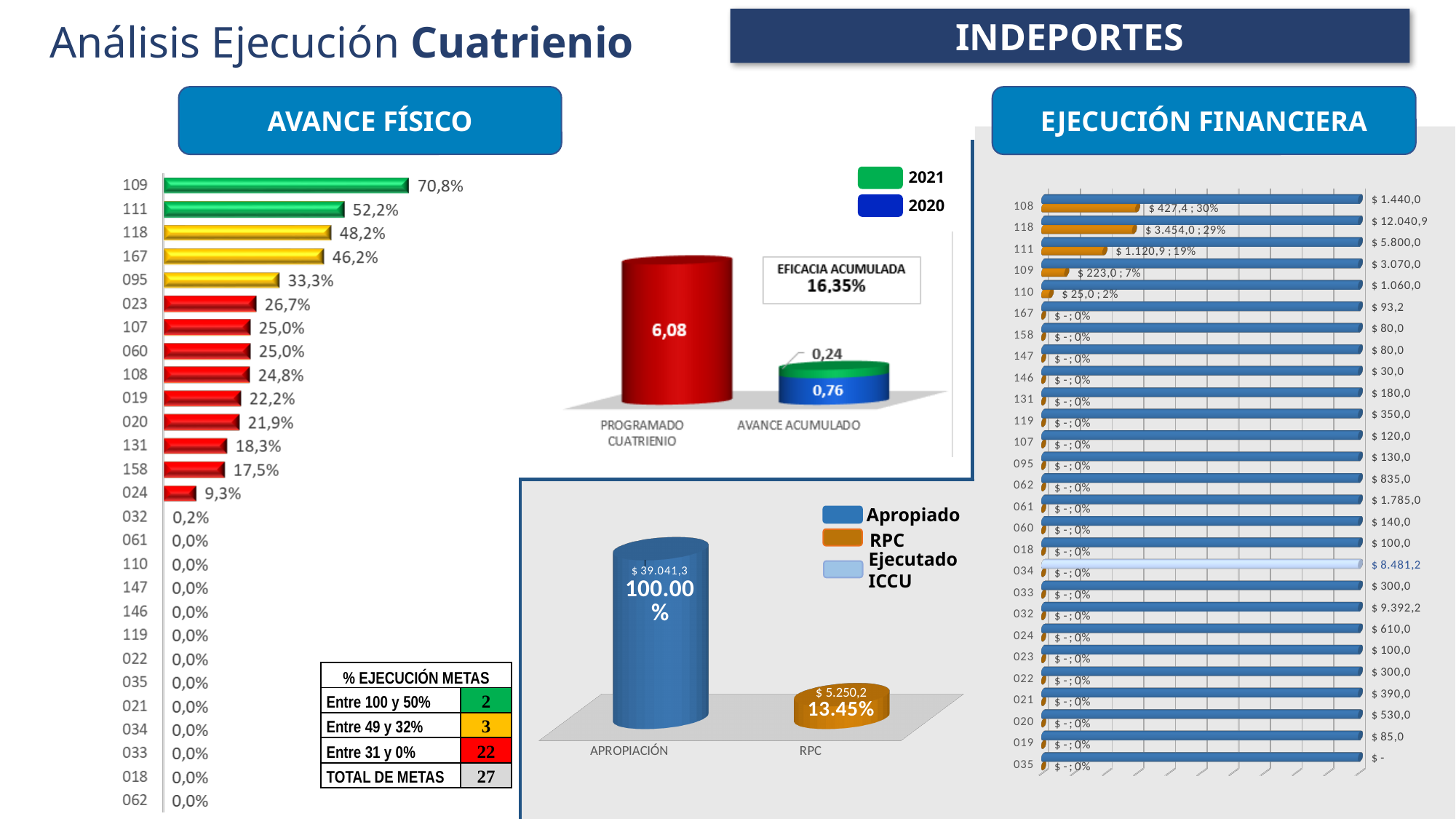
In the AVANCE FÍSICO chart, which category has the highest value? 109 In the APROPIACIÓN / RPC chart, what is the value for RPC? $ 5.250,2 What kind of chart is the EJECUCIÓN FINANCIERA chart? Bar chart In the PROGRAMADO CUATRIENIO / AVANCE ACUMULADO chart, what is the value for PROGRAMADO CUATRIENIO? 6,08 In the AVANCE FÍSICO chart, what is the value for category 109? 70,8% In the EJECUCIÓN FINANCIERA chart, what is the Apropiado value for category 118? $ 12.040,9 In the PROGRAMADO CUATRIENIO / AVANCE ACUMULADO chart, what is the EFICACIA ACUMULADA shown? 16,35% In the AVANCE FÍSICO chart, how many categories are plotted? 27 In the AVANCE FÍSICO chart, what is the difference between the values for 109 and 111? 18,6% In the AVANCE FÍSICO chart, which is larger, the value for 118 or the value for 095? 118 In the PROGRAMADO CUATRIENIO / AVANCE ACUMULADO chart, what is the 2021 value for AVANCE ACUMULADO? 0,24